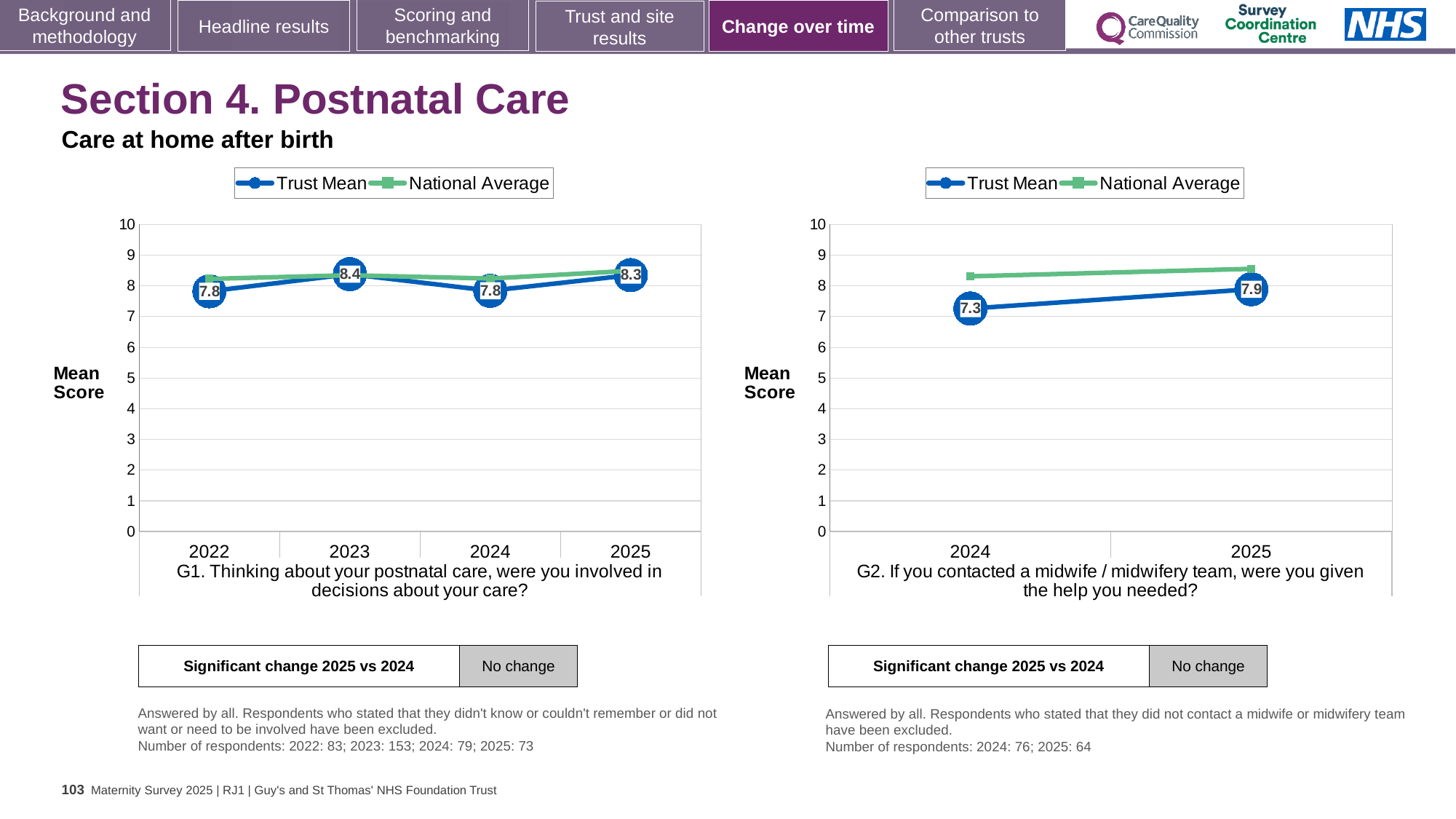
In the left chart (G1), which year has the highest Trust Mean score? 2023 In the right chart (G2), what is the difference between the Trust Mean scores for 2025 and 2024? 0.6 In the right chart (G2), what is the Trust Mean score for 2024? 7.3 How many series does the legend of the right chart (G2) list? 2 In the right chart (G2), is the National Average value for 2024 greater or less than 8? greater In the left chart (G1), what is the difference between the Trust Mean scores for 2023 and 2024? 0.6 In the left chart (G1), what is the Trust Mean score for 2023? 8.4 In the left chart (G1), what is the Trust Mean score for 2025? 8.3 In the right chart (G2), is the Trust Mean for 2025 larger or smaller than the Trust Mean for 2024? larger In the right chart (G2), what is the Trust Mean score for 2025? 7.9 What kind of chart is the left chart (G1)? Line chart How many years are plotted on the x axis of the left chart (G1)? 4